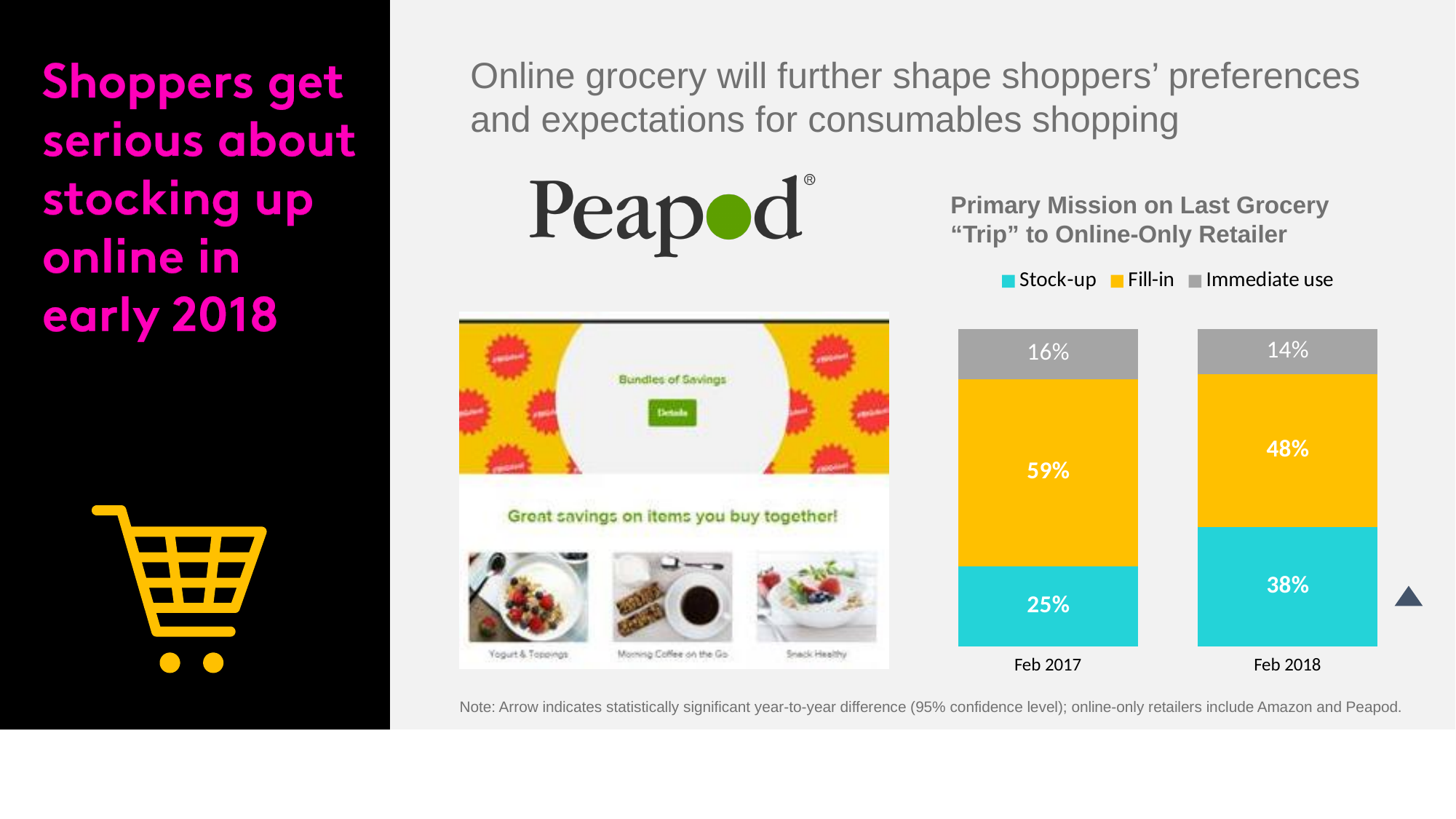
How many bars are shown in the chart? 2 Which segment is the largest in the Feb 2017 bar? Fill-in What is the Stock-up value for Feb 2017? 25% How many series does the legend list? 3 Which segment is the smallest in the Feb 2018 bar? Immediate use What is the Stock-up value for Feb 2018? 38% What is the Immediate use value for Feb 2017? 16% What kind of chart is shown? Stacked bar chart What is the Fill-in value for Feb 2018? 48% By how many percentage points did the Fill-in share change from Feb 2017 to Feb 2018? 11 percentage points Is the Stock-up share larger in Feb 2017 or Feb 2018? Feb 2018 What is the title of the chart? Primary Mission on Last Grocery "Trip" to Online-Only Retailer